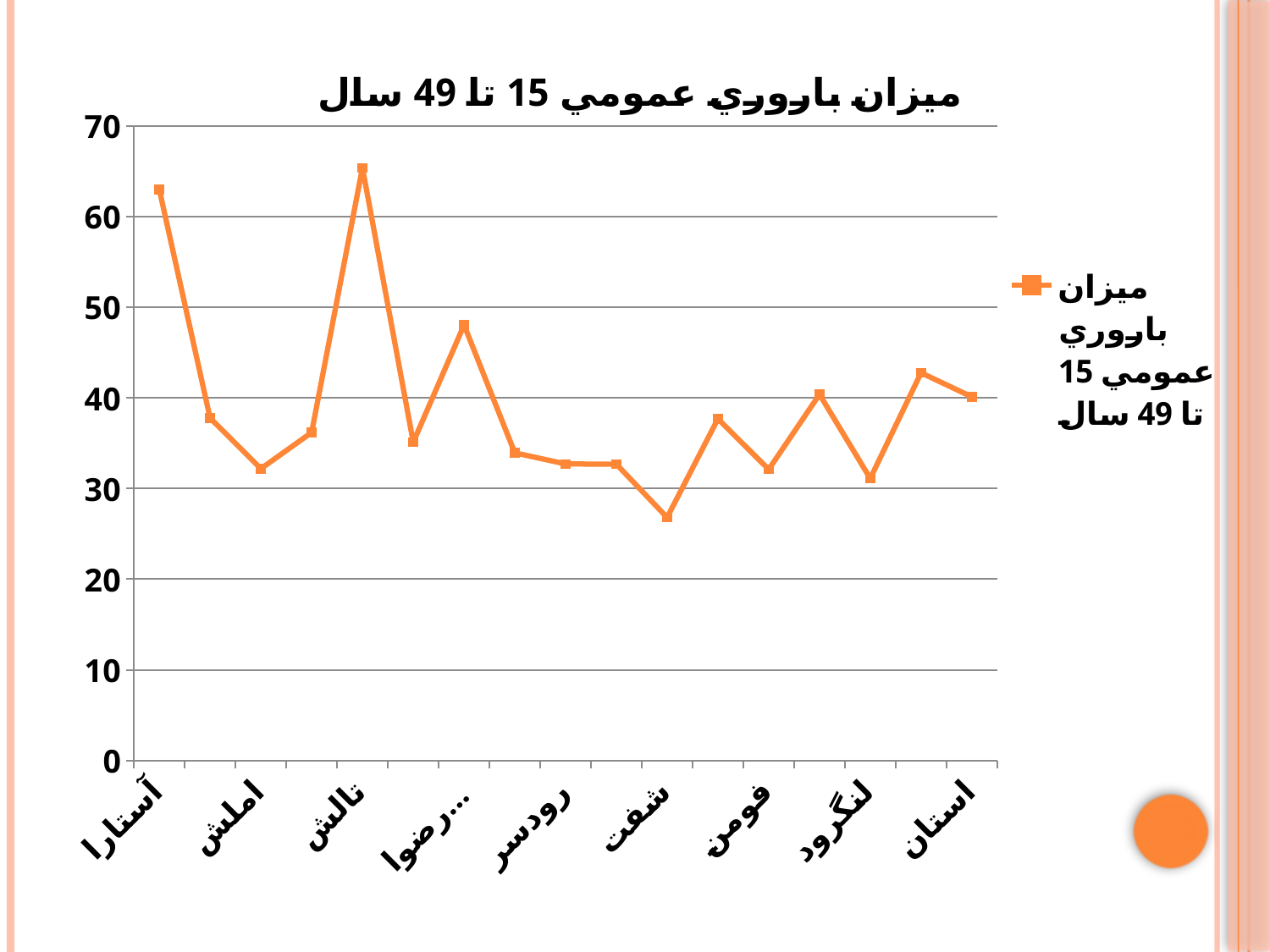
What kind of chart is shown on the slide? line chart Does the line rise or fall between آستارا and املش? fall Is the value for شفت greater or less than 30? less How many series does the legend list? 1 How many category labels are shown along the x axis? 9 What is the title of the chart? ميزان باروري عمومي 15 تا 49 سال Which is larger, the value for آستارا or the value for املش? آستارا Which labelled category has the lowest value? شفت Is the value for استان greater or less than 50? less Is the value for آستارا greater or less than 60? greater Which is larger, the value for لنگرود or the value for استان? استان Which labelled category has the highest value? تالش